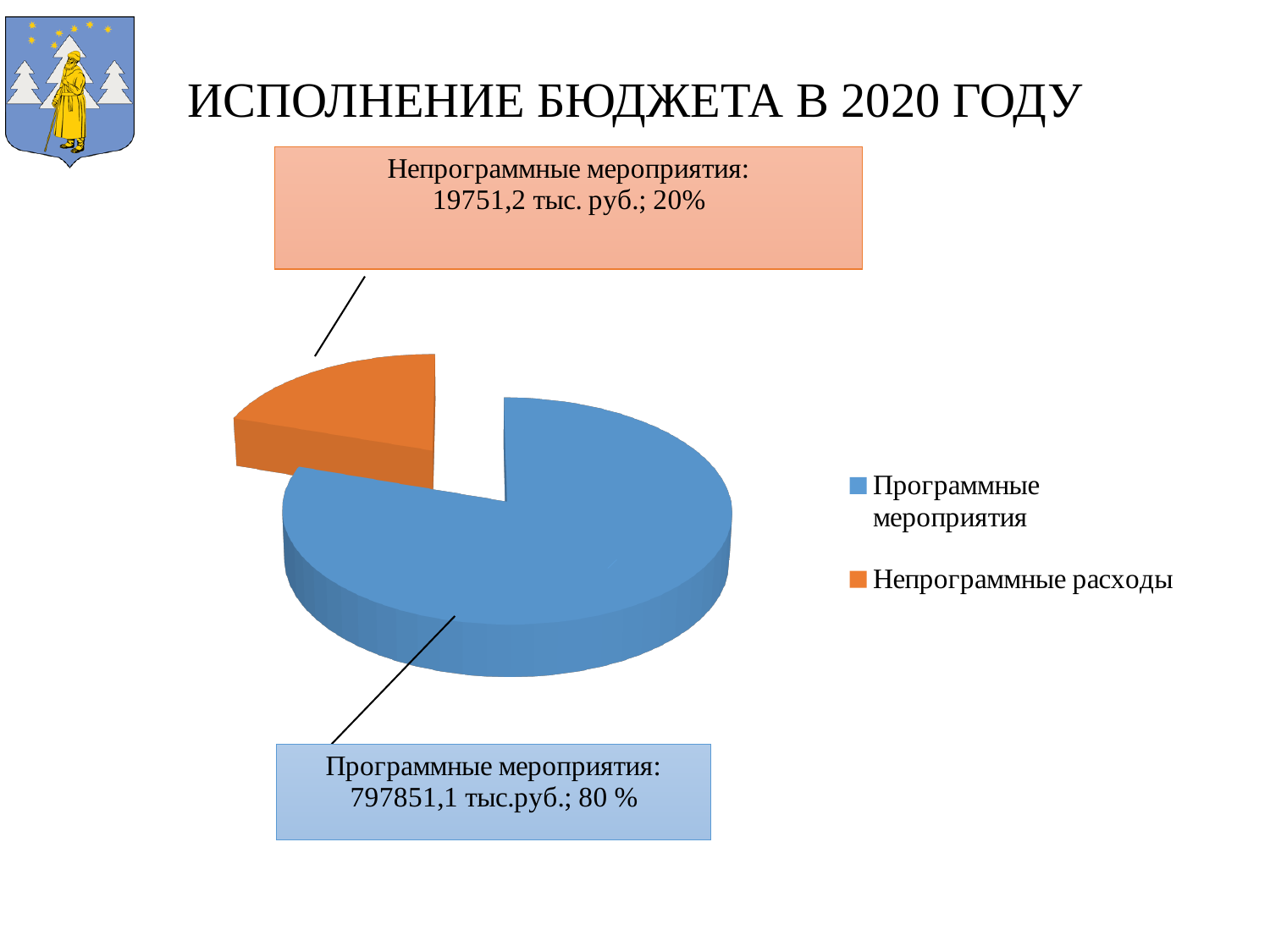
Which is larger, Программные мероприятия or Непрограммные мероприятия? Программные мероприятия What percentage share is labelled for Программные мероприятия? 80 % What percentage share is labelled for Непрограммные мероприятия? 20% What kind of chart is shown on the slide? Pie chart What value is shown for Непрограммные мероприятия? 19751,2 тыс. руб. Which slice of the pie is the largest? Программные мероприятия Which slice of the pie is the smallest? Непрограммные мероприятия What is the title of the slide containing the chart? ИСПОЛНЕНИЕ БЮДЖЕТА В 2020 ГОДУ What colour is the slice for Непрограммные расходы in the legend? Orange What value is shown for Программные мероприятия? 797851,1 тыс.руб. How many entries does the legend list? 2 How many slices does the pie chart have? 2